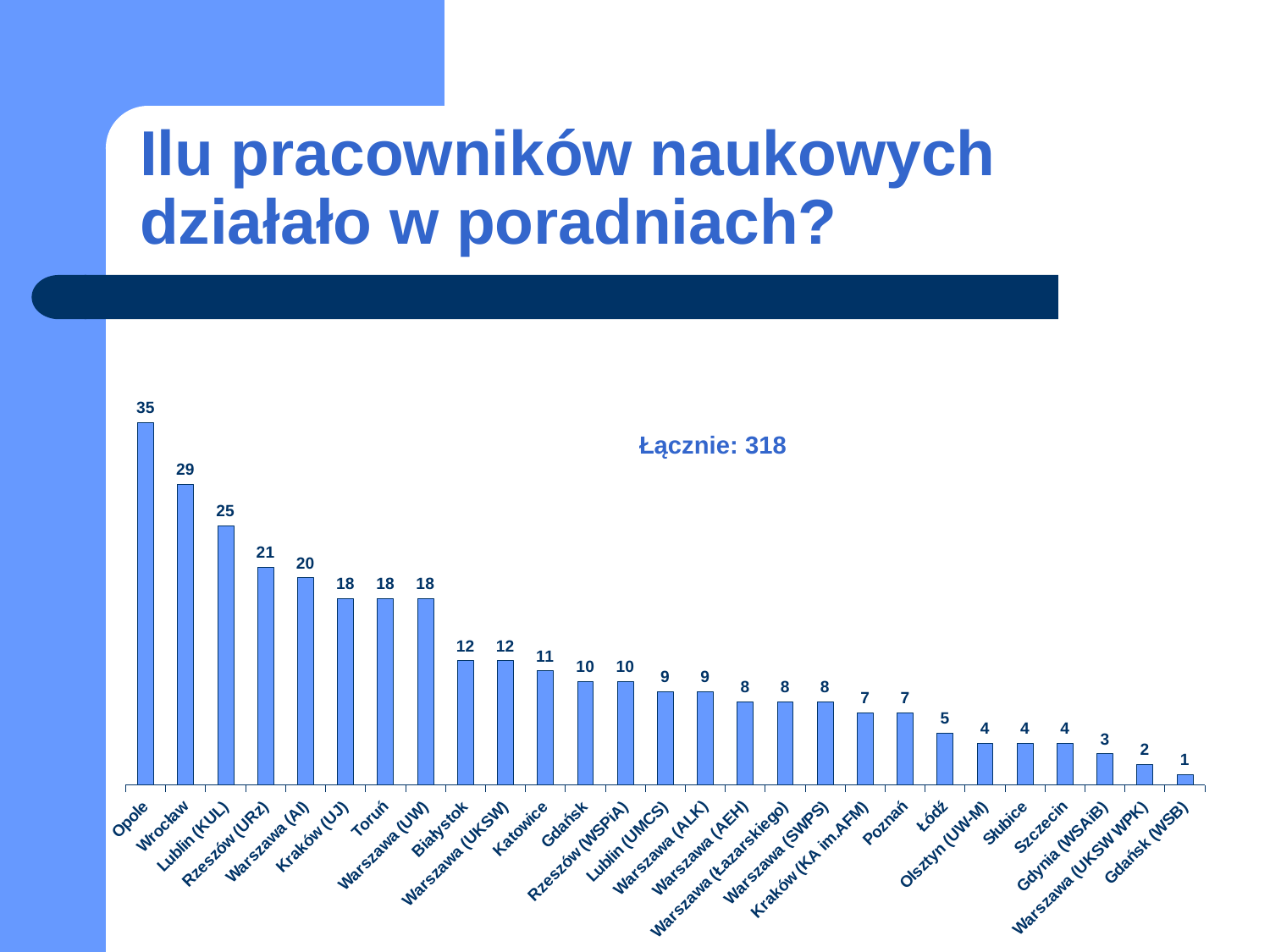
Which has a larger value, Łódź or Gdynia (WSAiB)? Łódź What is the value shown for Lublin (KUL)? 25 What total is stated in the text label inside the chart area? Łącznie: 318 How many categories (bars) are shown in the chart? 27 What is the difference between the values for Opole and Wrocław? 6 Which category has the highest value in the chart? Opole What type of chart is shown on the slide? Bar chart What value is labelled for Warszawa (SWPS)? 8 Which has a larger value, Białystok or Poznań? Białystok How many academic staff does the chart show for Opole? 35 Which category has the lowest value in the chart? Gdańsk (WSB) What is the difference between the values for Rzeszów (URz) and Katowice? 10